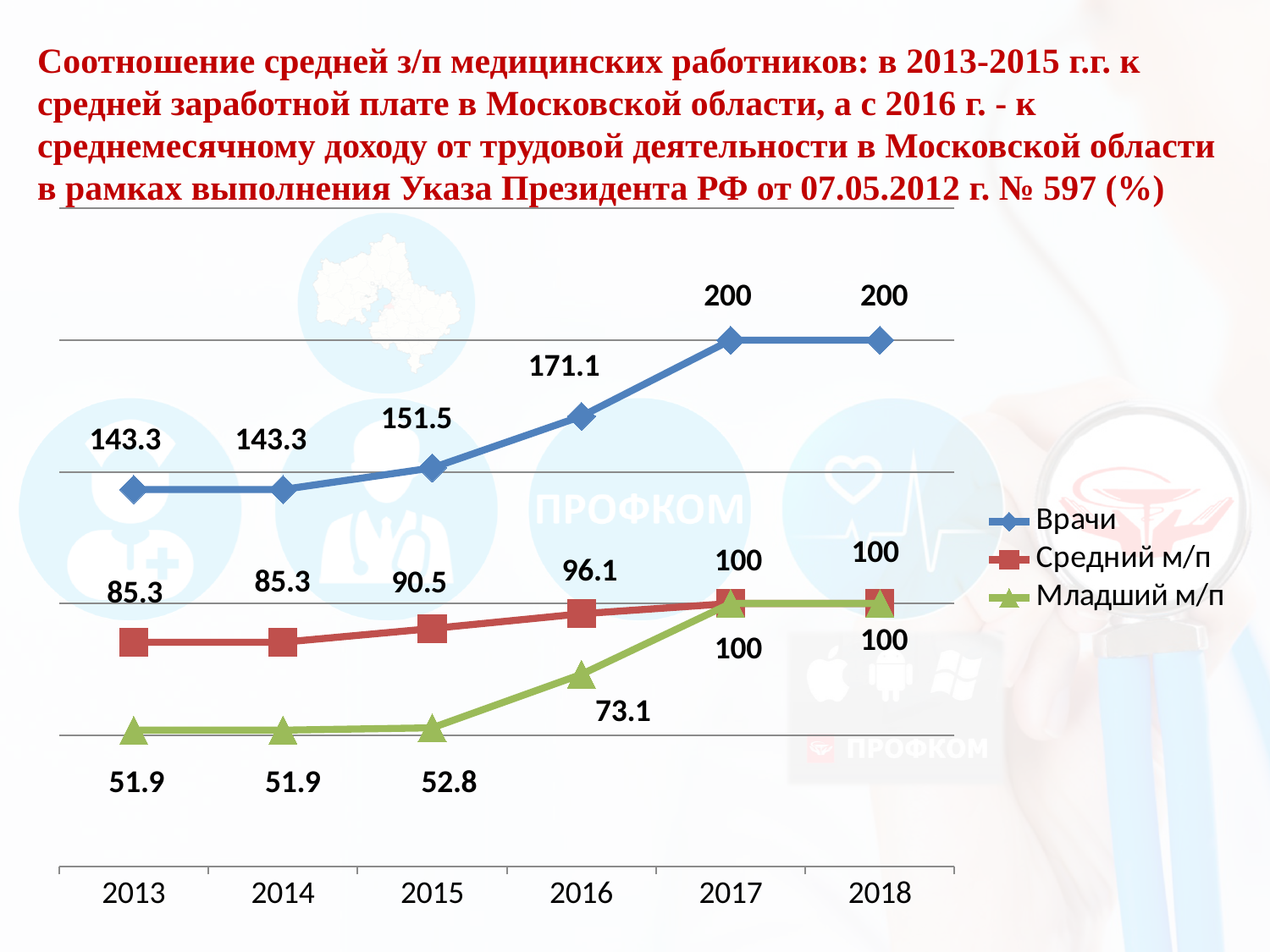
What is the value for Врачи in 2016? 171.1 What is the value for Средний м/п in 2015? 90.5 Which is larger in 2015: the value for Средний м/п or the value for Младший м/п? Средний м/п What is the value for Врачи in 2018? 200 What is the difference between the Врачи value in 2017 and in 2016? 28.9 Does the value for Врачи rise or fall from 2013 to 2018? rise How many years are shown on the x axis? 6 What type of chart is shown on the slide? line chart How many series does the legend list? 3 Which series is shown with a green line and triangle markers? Младший м/п What is the value for Младший м/п in 2016? 73.1 In which year is the value for Младший м/п lowest? 2013 and 2014 (51.9)